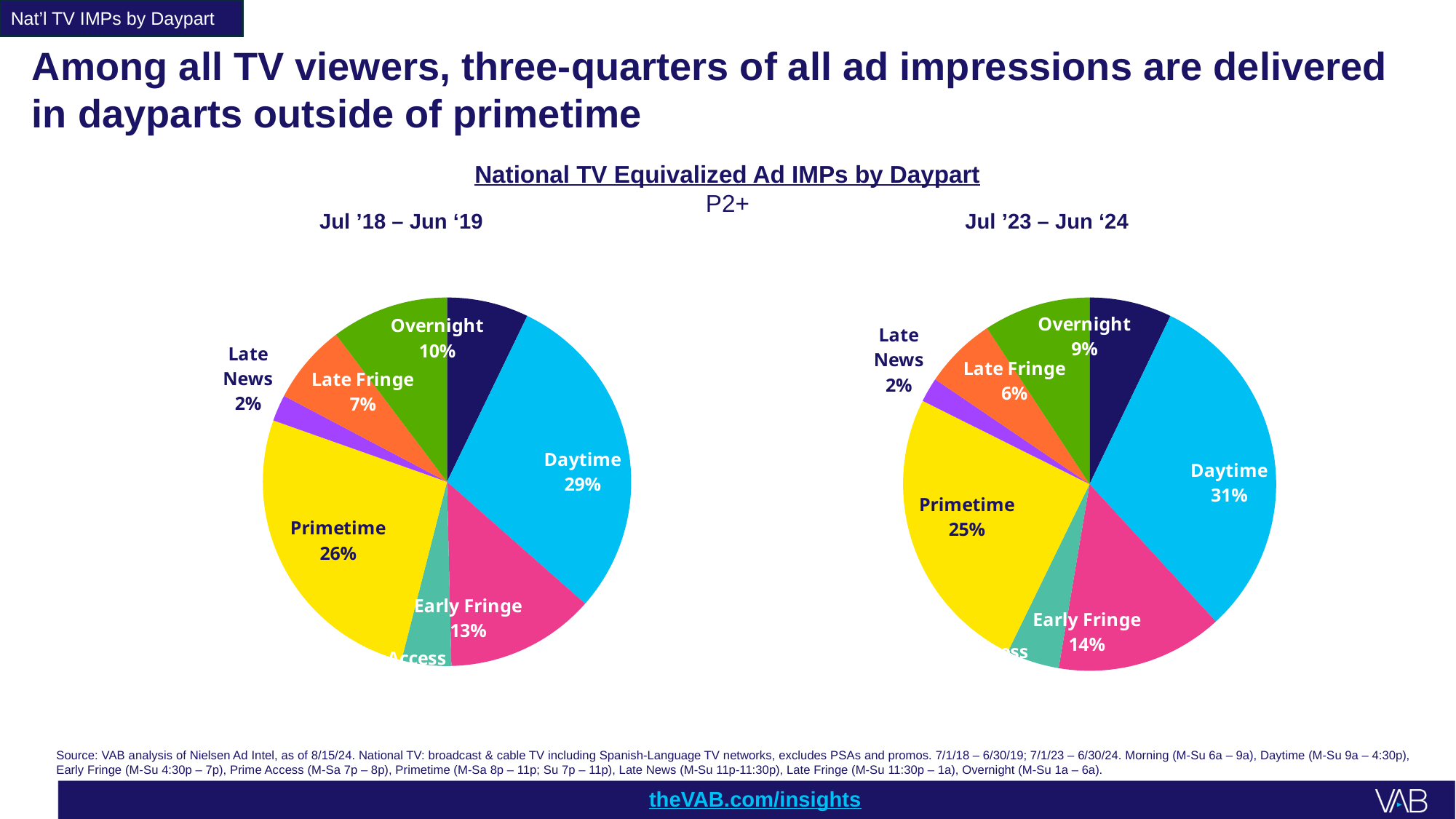
Is the Primetime share larger in the Jul '18 – Jun '19 chart or the Jul '23 – Jun '24 chart? Jul '18 – Jun '19 What is the difference between the Daytime share in the Jul '23 – Jun '24 chart and the Daytime share in the Jul '18 – Jun '19 chart? 2% What type of chart is used to show the Jul '18 – Jun '19 data? Pie chart In the Jul '18 – Jun '19 pie chart, what is the value for Overnight? 10% In the Jul '18 – Jun '19 pie chart, what share of ad impressions does Daytime account for? 29% In the Jul '23 – Jun '24 pie chart, which labeled daypart has the largest share? Daytime In the Jul '18 – Jun '19 pie chart, what is the difference between the Primetime and Early Fringe shares? 13% In the Jul '18 – Jun '19 pie chart, which labeled daypart has the smallest share? Late News How many slices does the Jul '23 – Jun '24 pie chart have? 8 In the Jul '23 – Jun '24 pie chart, what is the value for Late Fringe? 6% In the Jul '23 – Jun '24 pie chart, what share of ad impressions does Primetime account for? 25% In the Jul '23 – Jun '24 pie chart, which is larger: Early Fringe or Overnight? Early Fringe